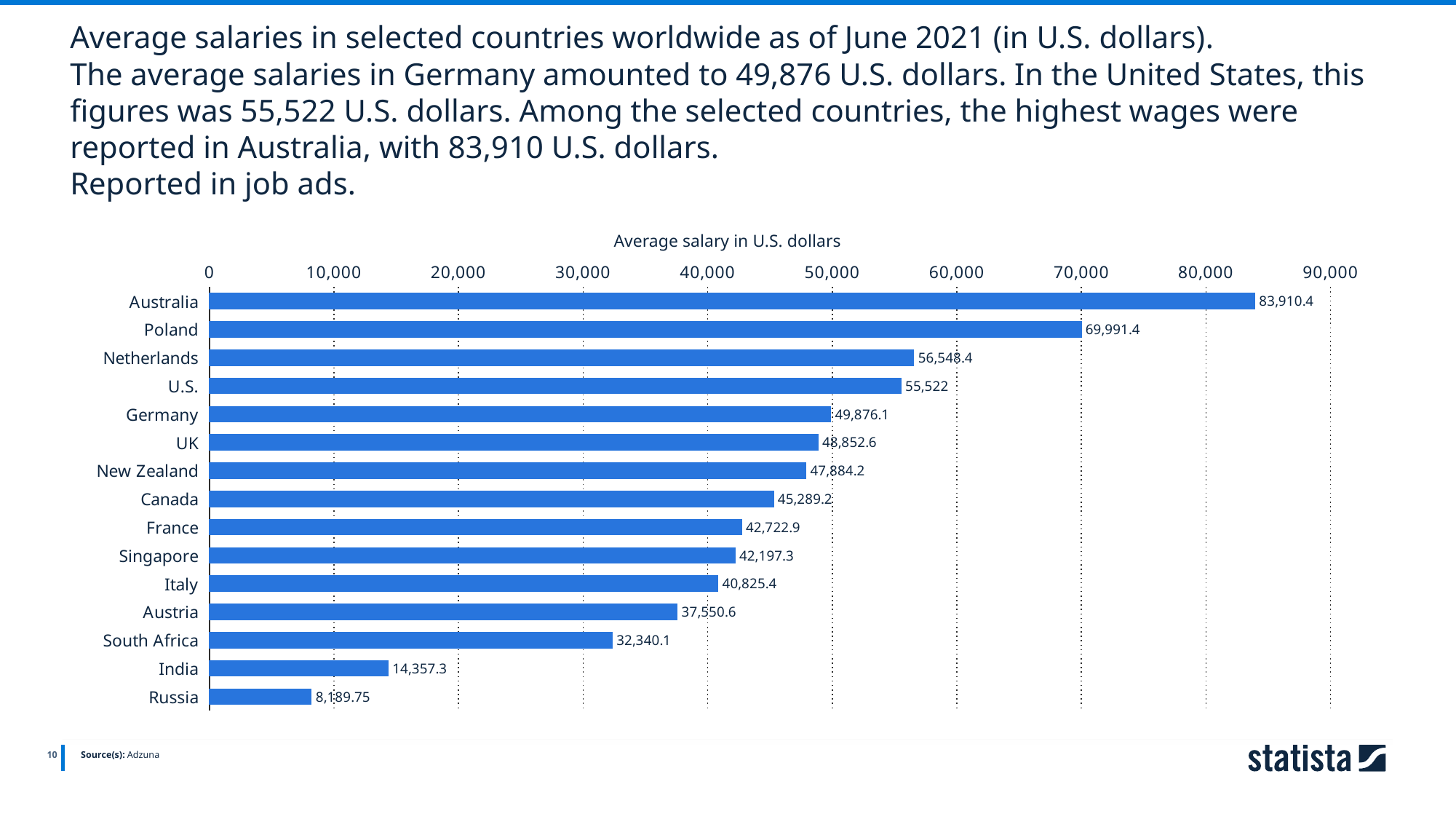
How many countries are shown in the chart? 15 What type of chart is shown on the slide? Bar chart What is the average salary shown for Australia? 83,910.4 What is the difference between the average salaries of Australia and Poland? 13,919 What is the average salary shown for Russia? 8,189.75 Which country has the lowest average salary in the chart? Russia What is the average salary shown for Poland? 69,991.4 What is the axis title shown above the chart? Average salary in U.S. dollars What is the average salary shown for Germany? 49,876.1 Which has a higher average salary, the Netherlands or the U.S.? Netherlands Which country has the highest average salary in the chart? Australia What is the difference between the average salaries of India and Russia? 6,167.55